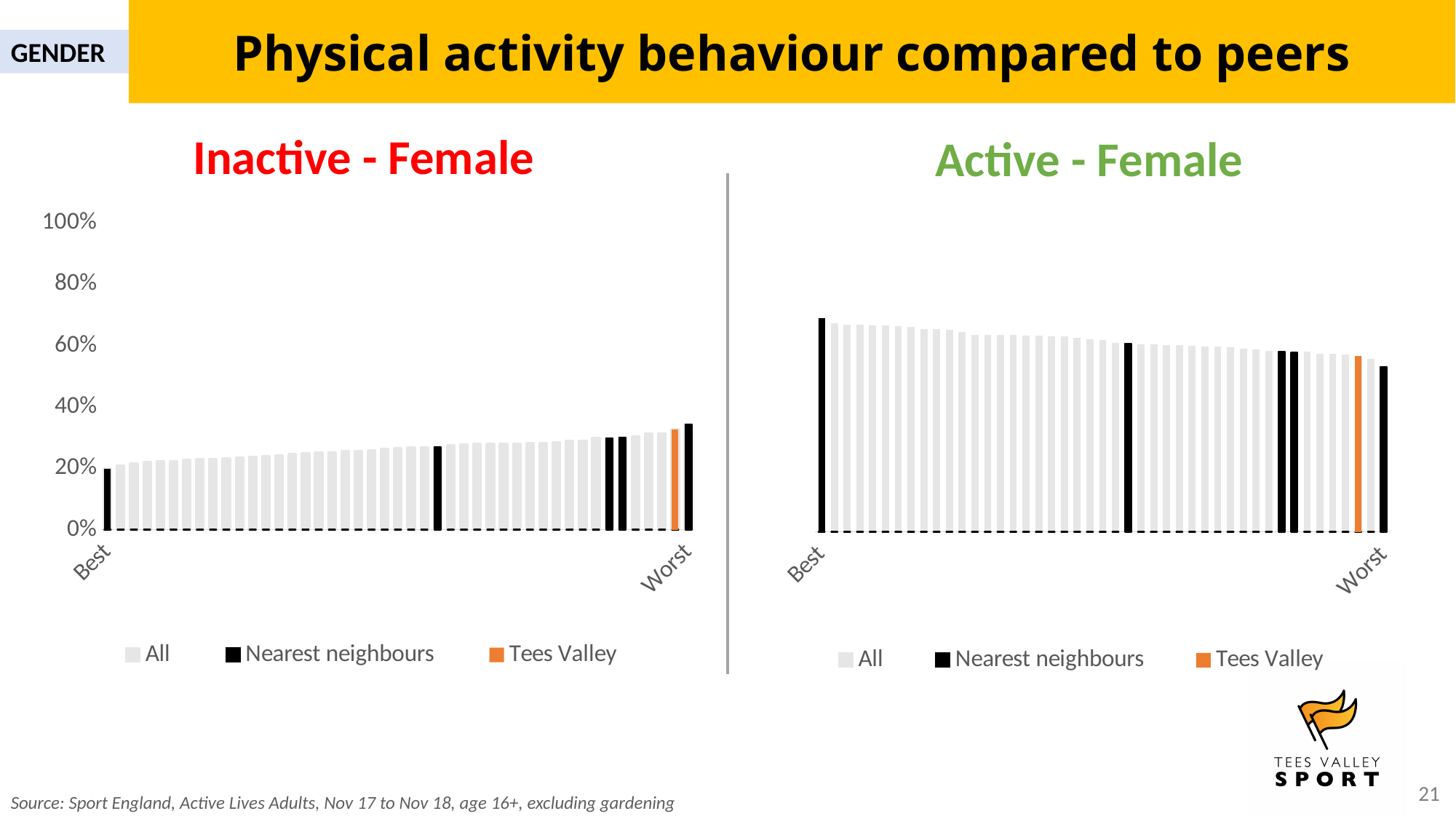
What kind of chart is the 'Inactive - Female' chart? bar chart In the 'Inactive - Female' chart, is the value of the Tees Valley bar greater or less than 20%? greater In the 'Active - Female' chart, do the bar values rise or fall from Best to Worst along the x axis? fall In the 'Active - Female' chart, is the value of the first bar at the Best end greater or less than 60%? greater In the 'Inactive - Female' chart, is the value of the Tees Valley bar greater or less than 40%? less In the 'Inactive - Female' chart, do the bar values rise or fall from Best to Worst along the x axis? rise In the 'Inactive - Female' chart, which is larger: the Tees Valley bar or the first bar at the Best end? Tees Valley bar In the legend of the 'Inactive - Female' chart, what colour represents Tees Valley? orange Which chart shows a higher value for the Tees Valley bar, 'Inactive - Female' or 'Active - Female'? Active - Female How many series does the legend of the 'Active - Female' chart list? 3